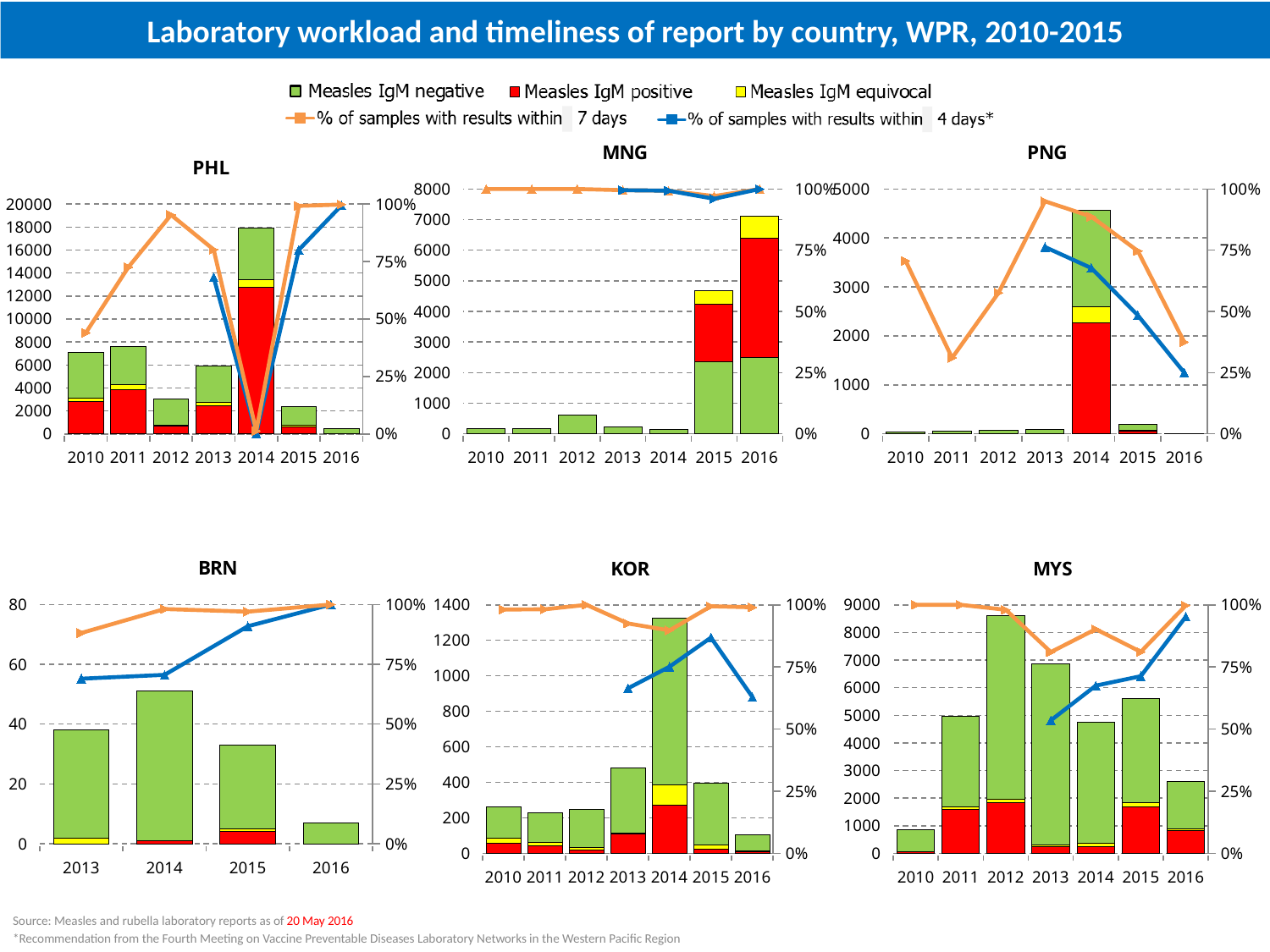
In the KOR chart, is the total bar height for 2014 greater or less than 1200? greater In the PHL chart, which year has the tallest stacked bar? 2014 In the PNG chart, does the '% of samples with results within 4 days*' line rise or fall from 2013 to 2016? fall How many years are shown on the x axis of the BRN chart? 4 In the MNG chart, is the total bar height for 2016 greater or less than 6000? greater In the MYS chart, is the total bar height for 2012 greater or less than 8000? greater In the PHL chart, which bar is taller, 2011 or 2012? 2011 How many series does the legend list for the charts on this slide? 5 In the PNG chart, which year has the tallest stacked bar? 2014 In the BRN chart, which year has the shortest bar? 2016 In the MYS chart, which year has the shortest bar? 2010